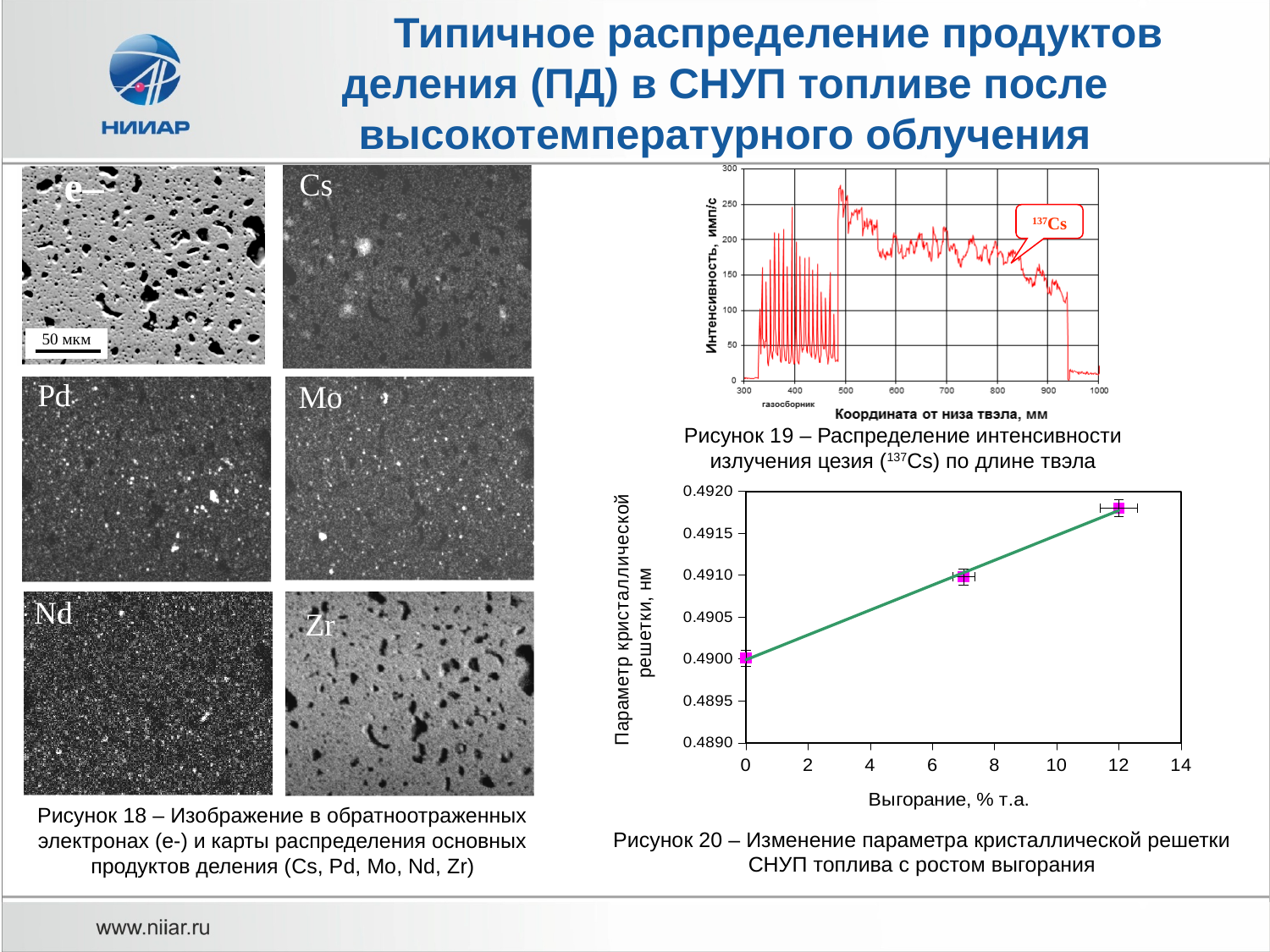
In Figure 20 (Рисунок 20), what kind of chart is shown? line chart In Figure 19 (Рисунок 19), is the intensity at a coordinate of 980 mm greater or less than 50 имп/с? less In Figure 19 (Рисунок 19), which isotope is named in the callout on the curve? 137Cs In Figure 20 (Рисунок 20), which plotted point has the lowest lattice parameter? the point at 0 % т.а. burnup In Figure 20 (Рисунок 20), which plotted point has the highest lattice parameter: the one at 0, about 7, or 12 % т.а. burnup? 12 % т.а. In Figure 20 (Рисунок 20), is the lattice parameter at a burnup of 12 % т.а. greater or less than 0.4915? greater In Figure 20 (Рисунок 20), is the lattice parameter at a burnup of about 7 % т.а. greater or less than 0.4905? greater In Figure 19 (Рисунок 19), what is the label of the x axis? Координата от низа твэла, мм In Figure 20 (Рисунок 20), does the lattice parameter rise or fall as burnup increases? rise In Figure 20 (Рисунок 20), how many data points are plotted? 3